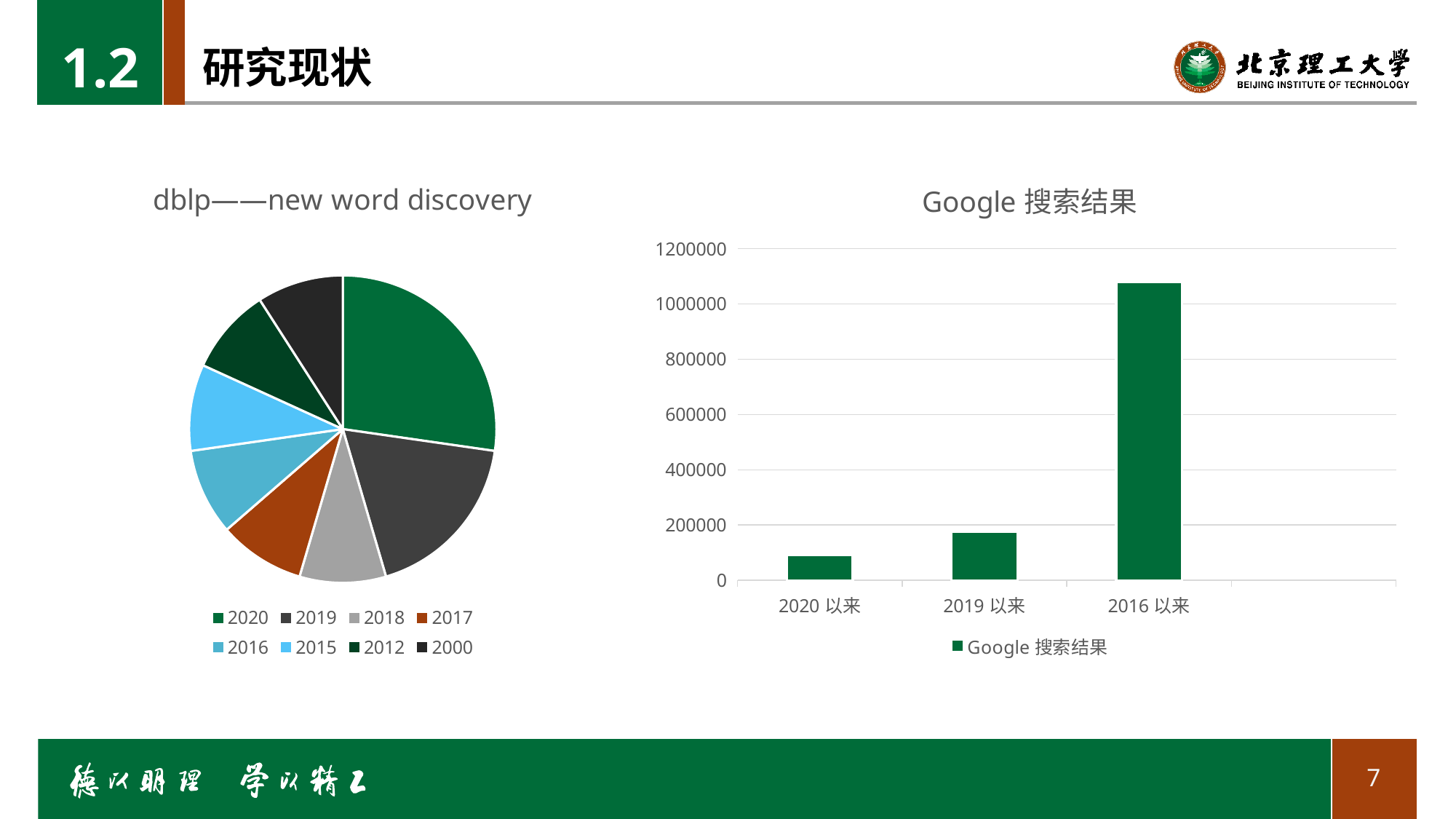
In the chart titled "Google 搜索结果", is the value for 2016 以来 greater or less than 1000000? greater In the chart titled "Google 搜索结果", which category has the lowest value? 2020 以来 In the chart titled "Google 搜索结果", which is larger, the value for 2019 以来 or the value for 2020 以来? 2019 以来 What kind of chart is the chart titled "Google 搜索结果"? bar chart In the chart titled "Google 搜索结果", which category has the highest value? 2016 以来 In the chart titled "Google 搜索结果", how many categories are shown on the x axis? 3 In the chart titled "dblp——new word discovery", which slice is the largest? 2020 In the chart titled "Google 搜索结果", is the value for 2020 以来 greater or less than 200000? less In the chart titled "Google 搜索结果", do the values rise or fall from left to right along the x axis? rise In the chart titled "dblp——new word discovery", how many slices does the pie have? 8 What kind of chart is the chart titled "dblp——new word discovery"? pie chart In the chart titled "Google 搜索结果", how many series does the legend list? 1